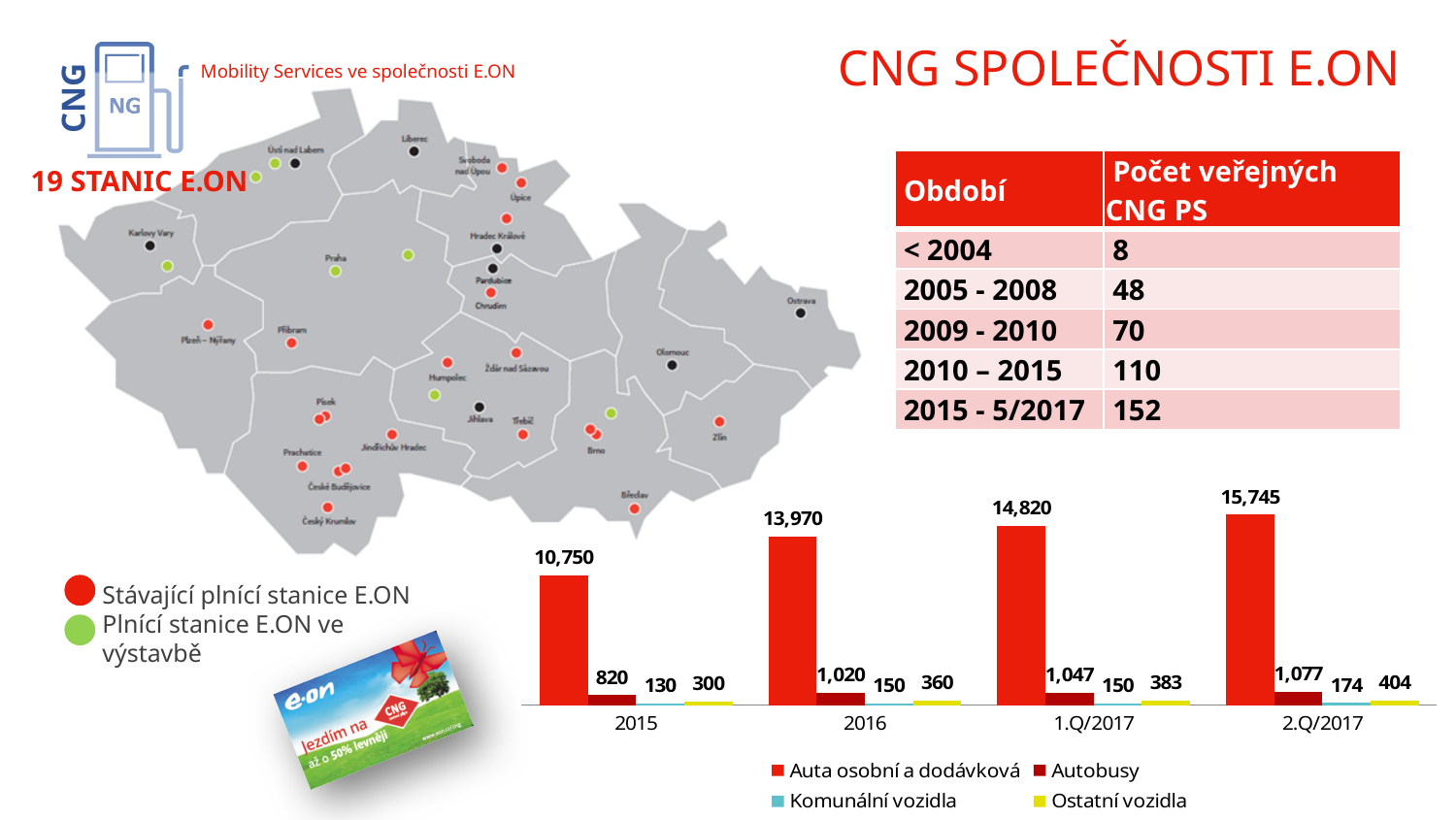
What is the value for Auta osobní a dodávková in 2016? 13,970 In which period is the value for Auta osobní a dodávková highest? 2.Q/2017 How many series does the legend of the bar chart list? 4 What is the value for Ostatní vozidla in 1.Q/2017? 383 Does the value for Auta osobní a dodávková rise or fall from 2015 to 2.Q/2017? rise Which is larger: Ostatní vozidla in 2016 or Ostatní vozidla in 2.Q/2017? 2.Q/2017 How many periods are shown on the x axis of the bar chart? 4 What is the difference between the Auta osobní a dodávková values for 2.Q/2017 and 1.Q/2017? 925 In which period is the value for Autobusy lowest? 2015 What is the value for Komunální vozidla in 2015? 130 What kind of chart is shown at the bottom right of the slide? bar chart What is the value for Autobusy in 2.Q/2017? 1,077